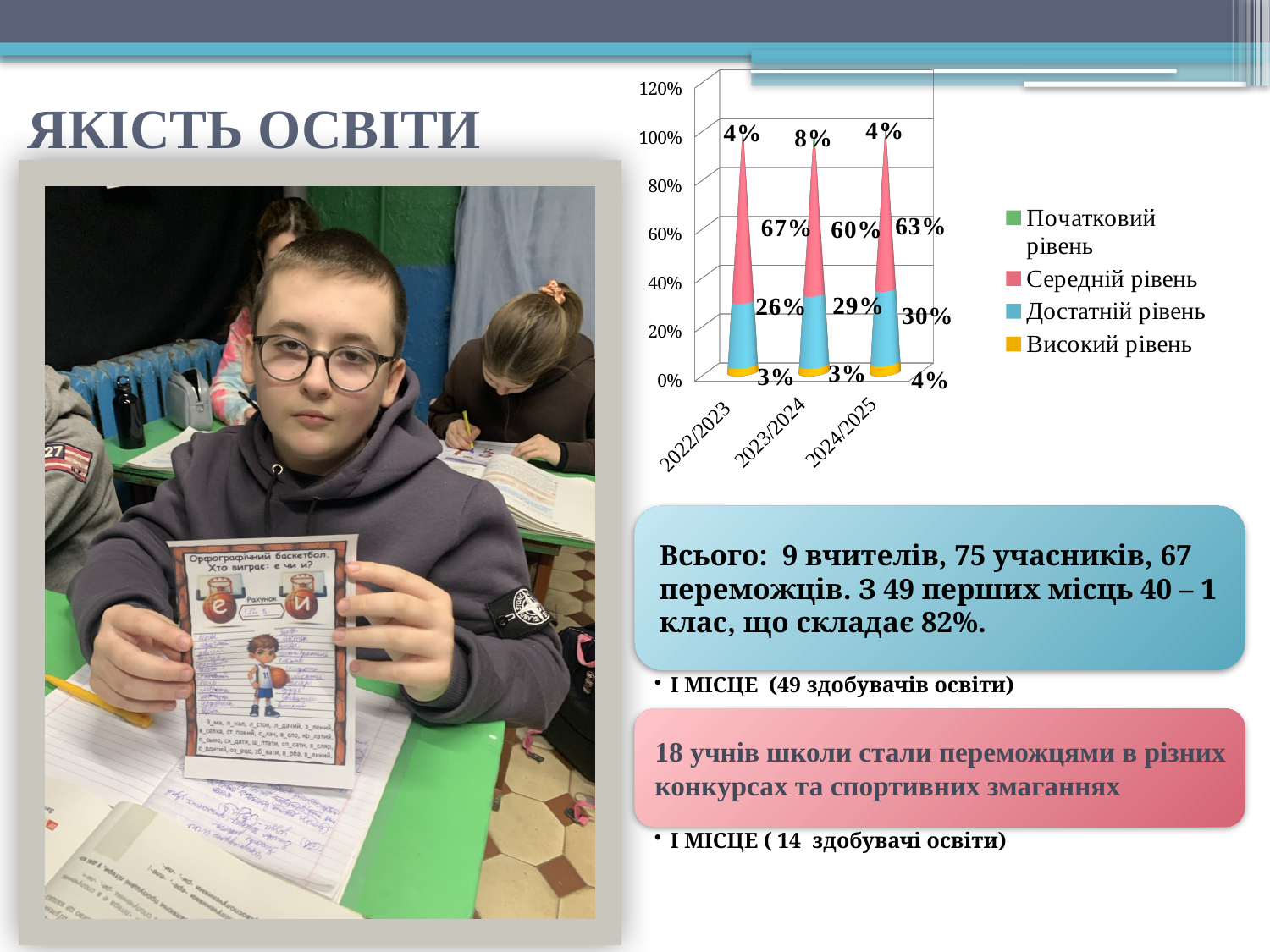
In which year is the value for Середній рівень the highest? 2022/2023 How many series does the chart legend list? 4 Which is larger: Початковий рівень in 2023/2024 or Початковий рівень in 2024/2025? 2023/2024 What is the value for Середній рівень in 2022/2023? 67% In which year is the value for Достатній рівень the lowest? 2022/2023 How many years are shown on the x axis of the chart? 3 What kind of chart is shown on the slide? Stacked bar chart What is the value for Достатній рівень in 2023/2024? 29% What is the total of the stacked bar for 2024/2025? 101% What is the difference between the Середній рівень values for 2022/2023 and 2023/2024? 7% What is the value for Початковий рівень in 2023/2024? 8% What is the value for Високий рівень in 2024/2025? 4%